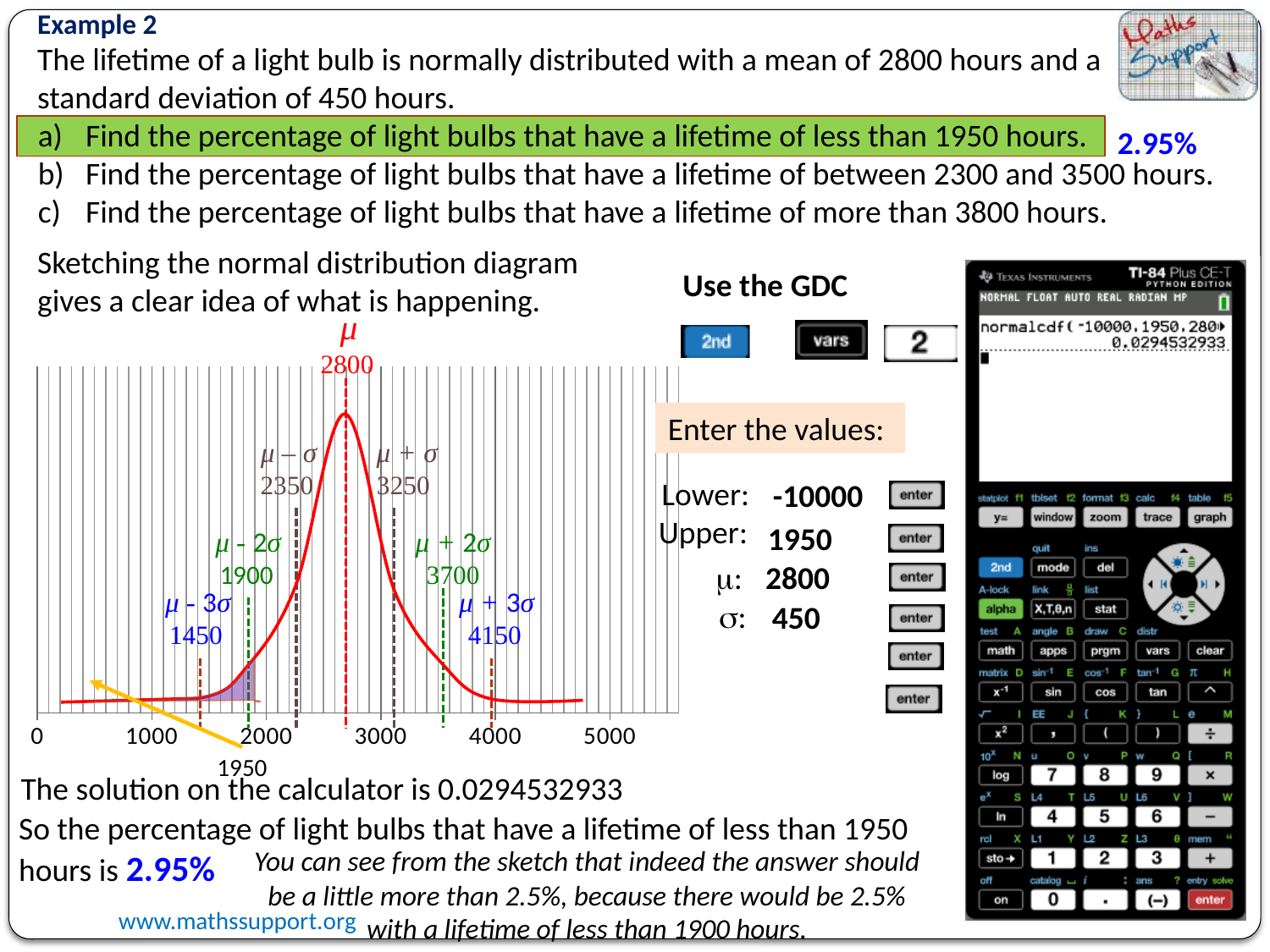
Which is larger on the sketch, the value at μ + 2σ or the value at μ + 3σ? μ + 3σ What value does the yellow arrow on the sketch point to? 1950 What is the difference between the values labelled at μ + σ and μ − σ on the sketch? 900 What value is labelled at μ − 2σ on the normal distribution sketch? 1900 What value is labelled at the mean (μ) on the normal distribution sketch? 2800 What is the largest value shown on the x axis of the normal distribution sketch? 5000 What colour is the normal distribution curve drawn in on the sketch? Red What value is labelled at μ + σ on the normal distribution sketch? 3250 What value is labelled at μ − σ on the normal distribution sketch? 2350 What value is labelled at μ + 2σ on the normal distribution sketch? 3700 What value is labelled at μ + 3σ on the normal distribution sketch? 4150 What value is labelled at μ − 3σ on the normal distribution sketch? 1450